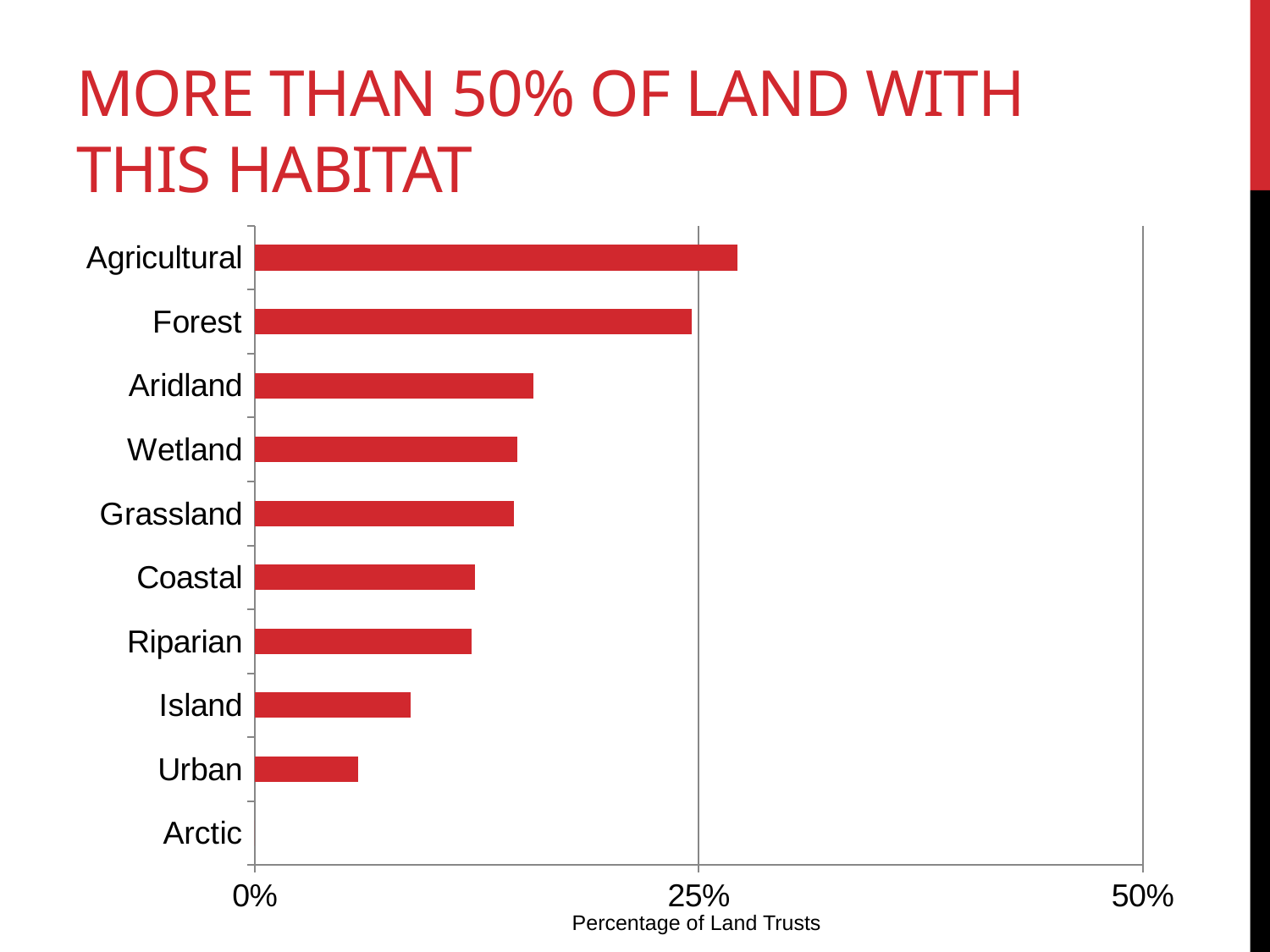
Is the value for Aridland greater or less than 25%? less Is the value for Agricultural greater or less than 25%? greater How many habitat categories are plotted on the chart? 10 Is the value for Urban greater or less than 25%? less What is the label on the horizontal axis of the chart? Percentage of Land Trusts Which has a larger value, Aridland or Coastal? Aridland Do the bar values increase or decrease going from the top category to the bottom category? decrease Which habitat has the highest percentage of land trusts? Agricultural Which habitat has the lowest percentage of land trusts? Arctic Which has a larger value, Agricultural or Forest? Agricultural Which has a larger value, Island or Urban? Island What kind of chart is shown on the slide? bar chart